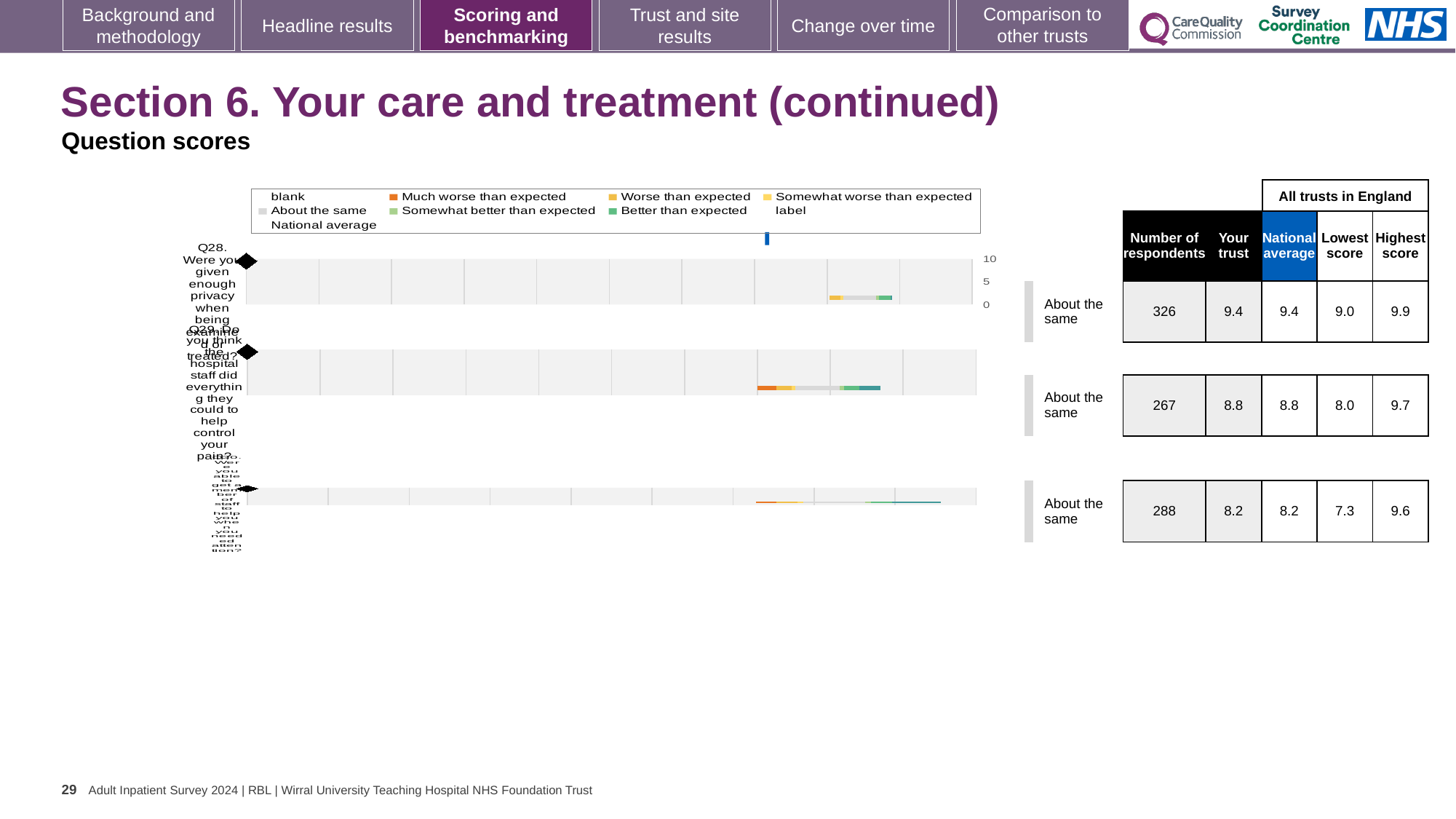
What is the 'Your trust' score for Q28 (Were you given enough privacy when being examined or treated?)? 9.4 Which question has the highest 'Your trust' score? Q28 What benchmark category is shown next to the Q29 chart? About the same What is the national average score for Q29 (Do you think the hospital staff did everything they could to help control your pain?)? 8.8 What kind of chart is used to show the question scores on this slide? bar chart What is the lowest score among all trusts in England for Q30? 7.3 How many questions (Q28, Q29, Q30) are plotted on this slide? 3 What is the difference between the 'Your trust' score for Q28 and for Q30? 1.2 How many respondents answered Q30 (Were you able to get a member of staff to help you when you needed attention?)? 288 Which has the larger 'Your trust' score, Q29 or Q30? Q29 What is the highest score among all trusts in England for Q28? 9.9 Which question has the lowest 'Your trust' score? Q30